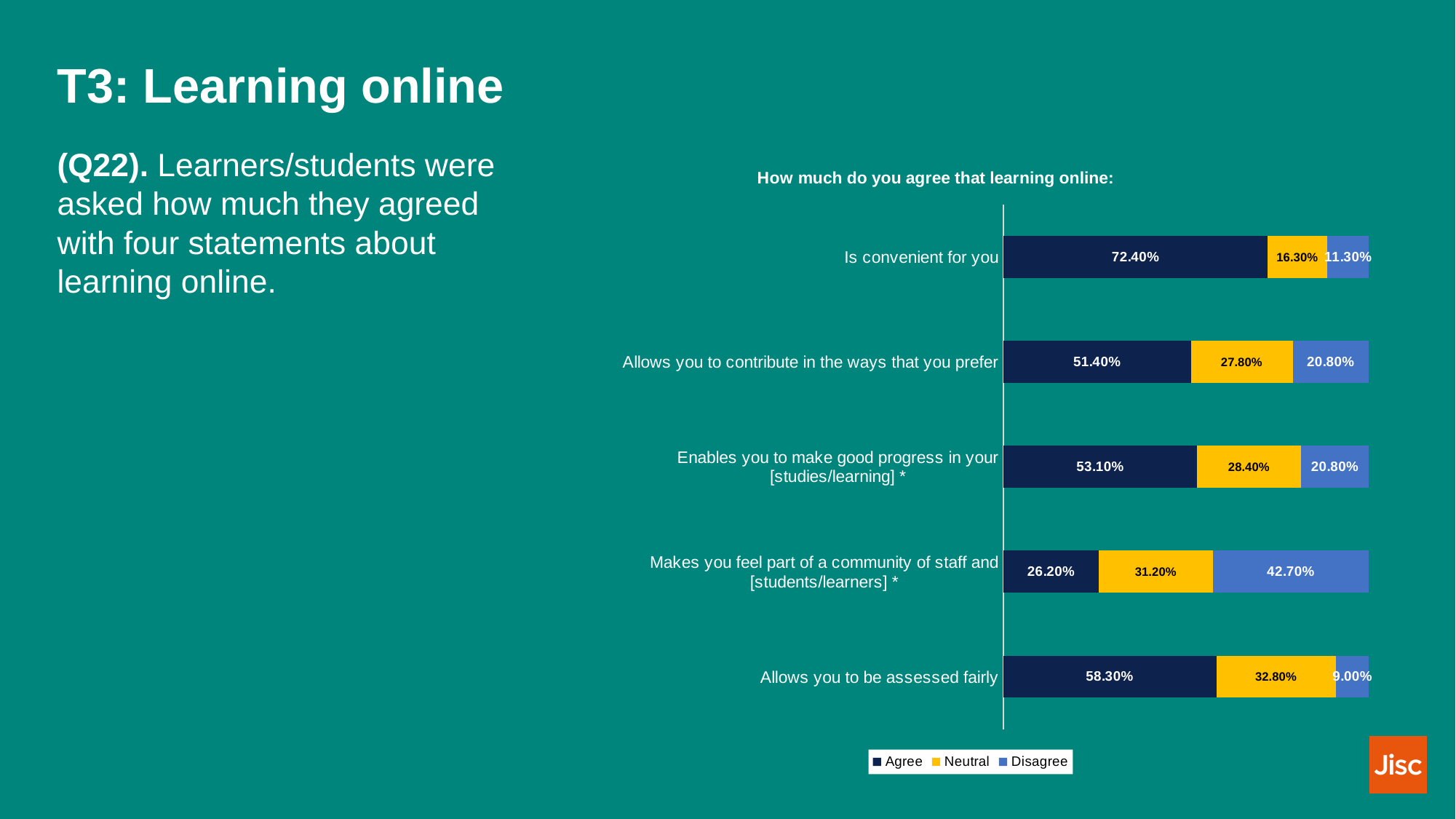
What kind of chart is shown on the slide? Stacked bar chart What is the Disagree value for 'Makes you feel part of a community of staff and [students/learners]'? 42.70% What is the title of the chart? How much do you agree that learning online: Which statement has the lowest Agree percentage? Makes you feel part of a community of staff and [students/learners] What is the total of the three segments for 'Is convenient for you'? 100.00% What is the difference between the Agree percentages for 'Is convenient for you' and 'Allows you to be assessed fairly'? 14.10% What percentage of learners agree that learning online is convenient for them? 72.40% What is the Neutral value for 'Allows you to be assessed fairly'? 32.80% How many series does the legend list? 3 How many statements are shown in the chart? 5 Which statement has the highest Agree percentage? Is convenient for you Which is larger: the Neutral value for 'Allows you to contribute in the ways that you prefer' or the Neutral value for 'Enables you to make good progress in your [studies/learning]'? Enables you to make good progress in your [studies/learning]